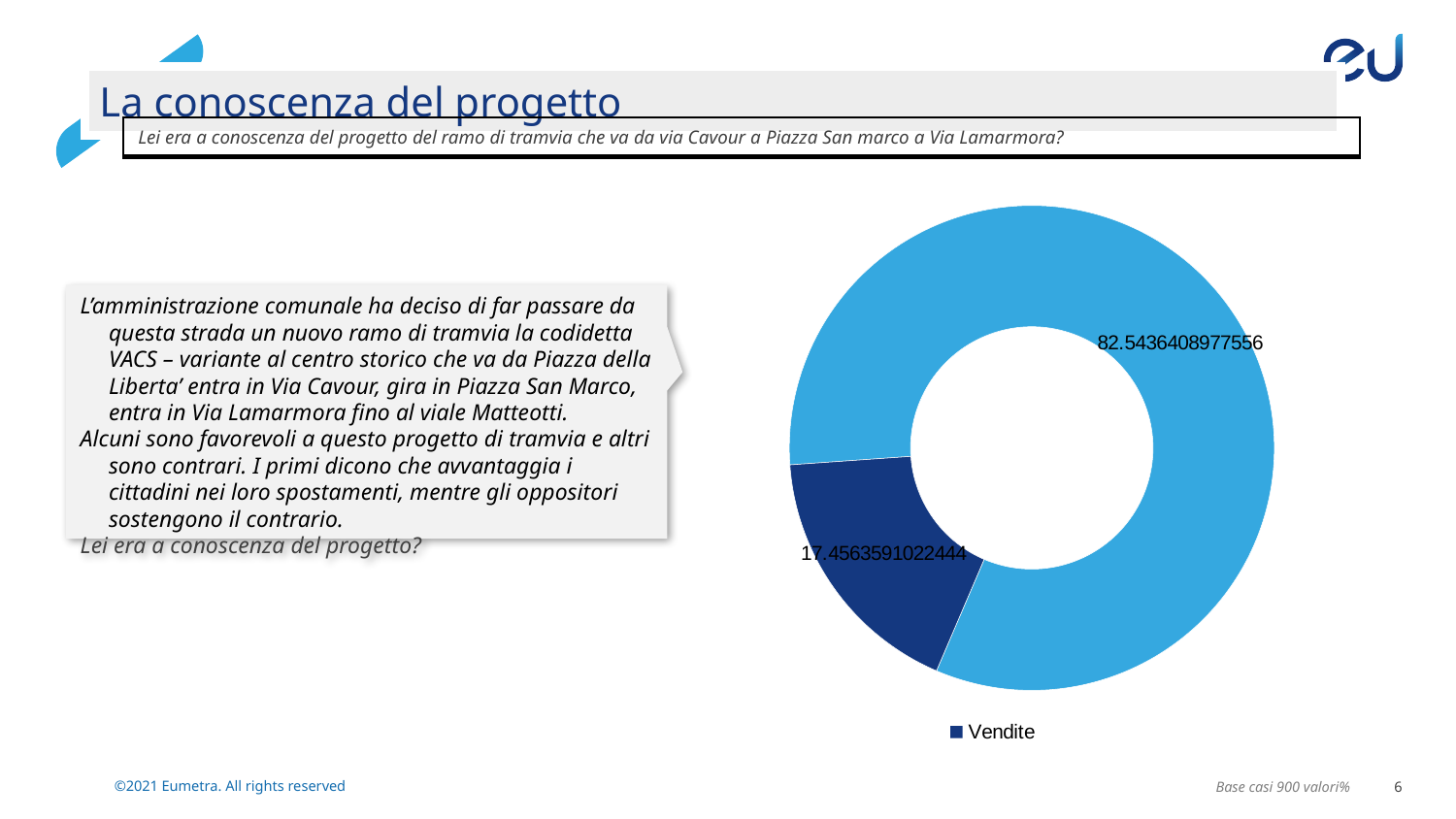
What is the value printed on the smaller (dark blue) slice of the doughnut chart? 17.4563591022444 What is the value printed on the larger (light blue) slice of the doughnut chart? 82.5436408977556 Is the value of the light blue slice greater or less than 80? greater What is the legend entry shown below the doughnut chart? Vendite Which slice of the doughnut chart is the largest, the light blue one or the dark blue one? The light blue one What is the difference between the two values shown on the doughnut chart? 65.0872817955112 Which slice of the doughnut chart is the smallest, the light blue one or the dark blue one? The dark blue one How many entries does the legend of the doughnut chart list? 1 What is the total of the two values shown on the doughnut chart? 100 What type of chart is shown on the slide? Doughnut chart How many slices does the doughnut chart have? 2 Is the value of the dark blue slice greater or less than 20? less